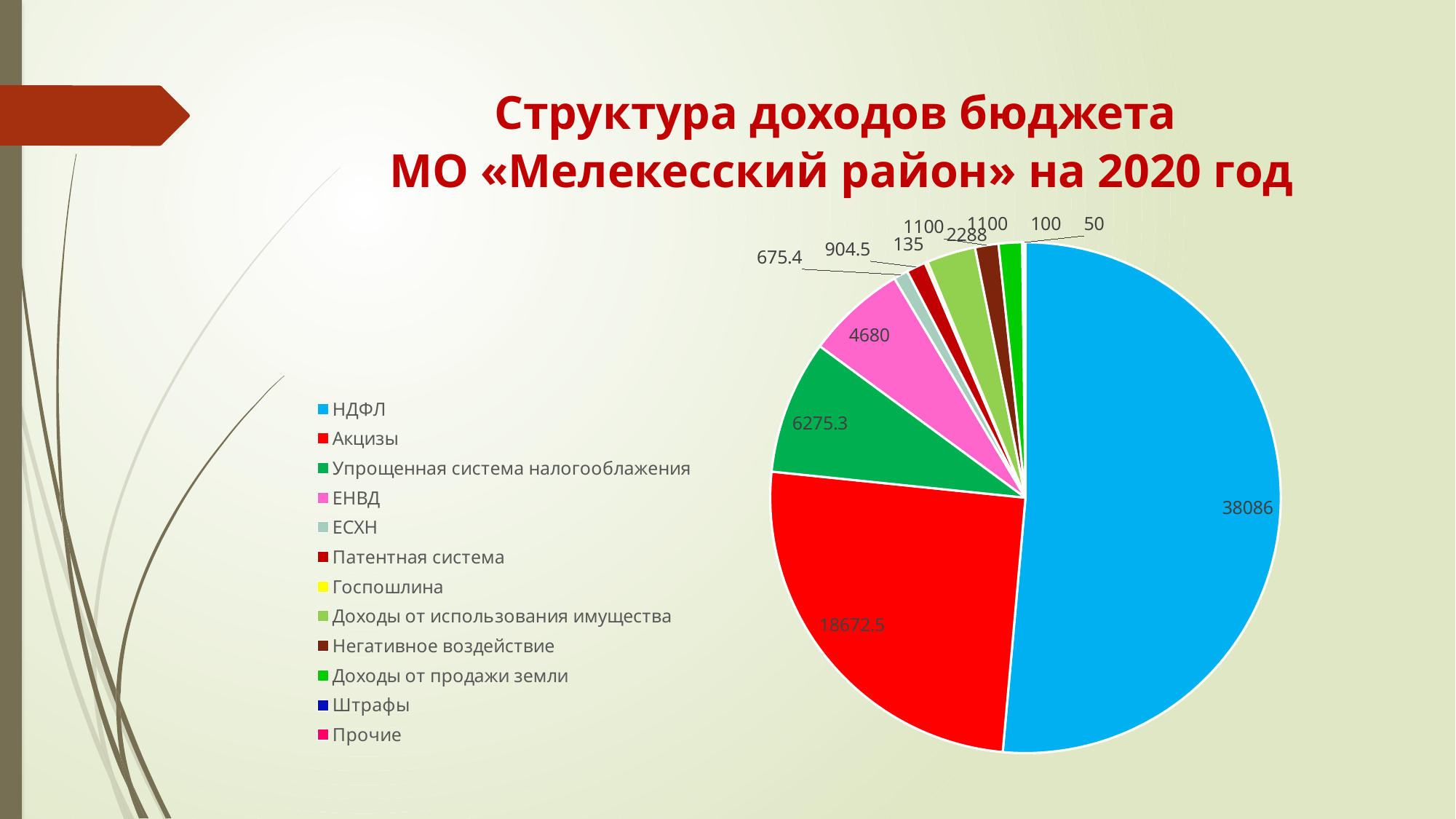
How many categories does the legend list? 12 What type of chart is shown on the slide? pie chart What is the value for Негативное воздействие? 1100 What is the value for Упрощенная система налогооблажения? 6275.3 What is the value for Акцизы? 18672.5 What is the difference between the values for Упрощенная система налогооблажения and ЕНВД? 1595.3 What is the value for ЕНВД? 4680 Which category has the largest slice of the pie? НДФЛ What is the difference between the values for НДФЛ and Акцизы? 19413.5 What is the title of the chart on the slide? Структура доходов бюджета МО «Мелекесский район» на 2020 год Which is larger, the value for Акцизы or the value for Упрощенная система налогооблажения? Акцизы What is the value for НДФЛ? 38086